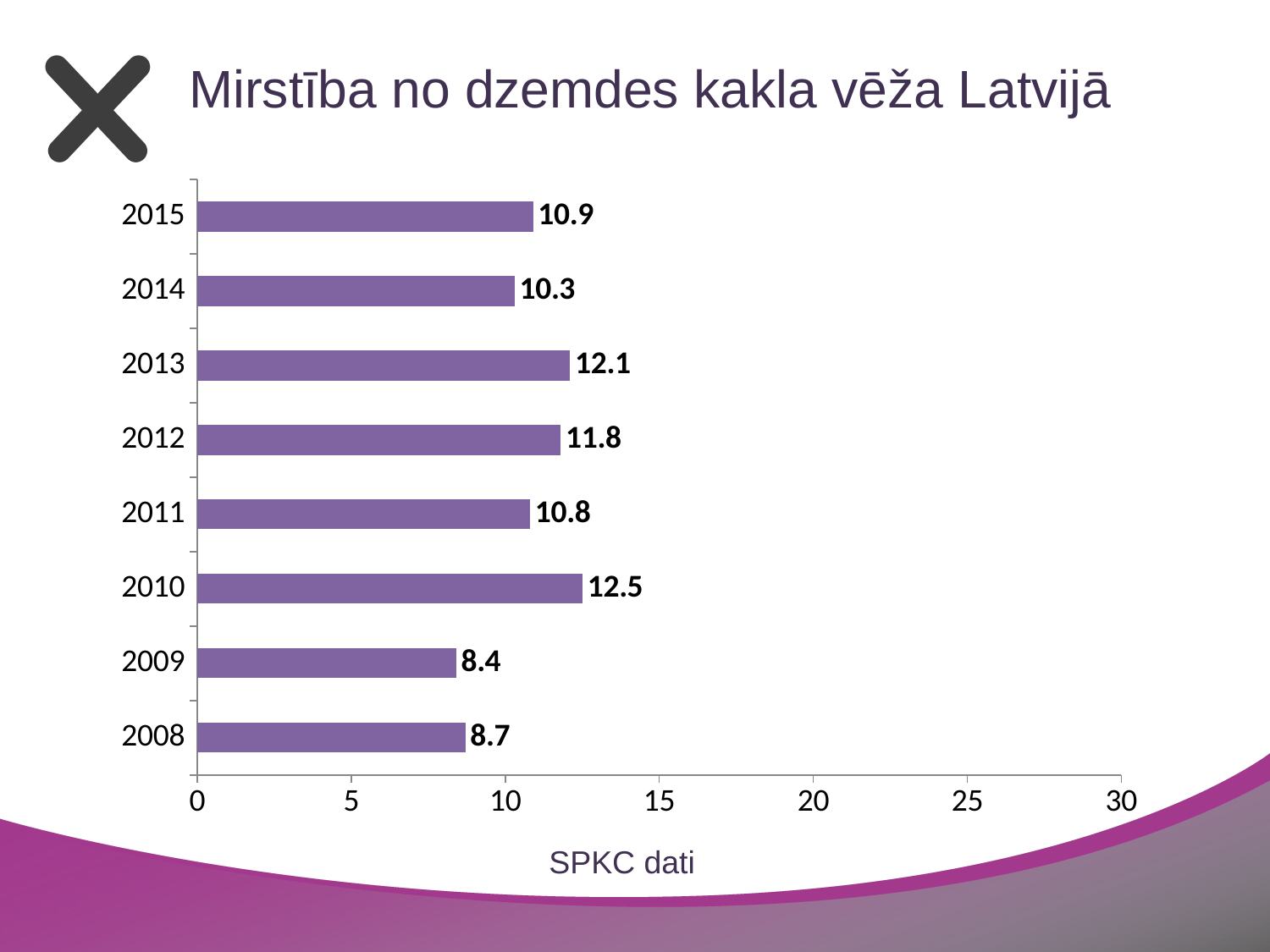
Which year has the lowest value? 2009 What is the value for 2009? 8.4 How many years are shown in the chart? 8 What is the difference between the values for 2015 and 2014? 0.6 Is the value for 2008 greater or less than 10? less What is the value for 2015? 10.9 What is the title of the slide? Mirstība no dzemdes kakla vēža Latvijā Which year has the highest value? 2010 What is the value for 2012? 11.8 Which is larger, the value for 2013 or the value for 2011? 2013 What is the difference between the values for 2010 and 2009? 4.1 What kind of chart is shown on the slide? bar chart